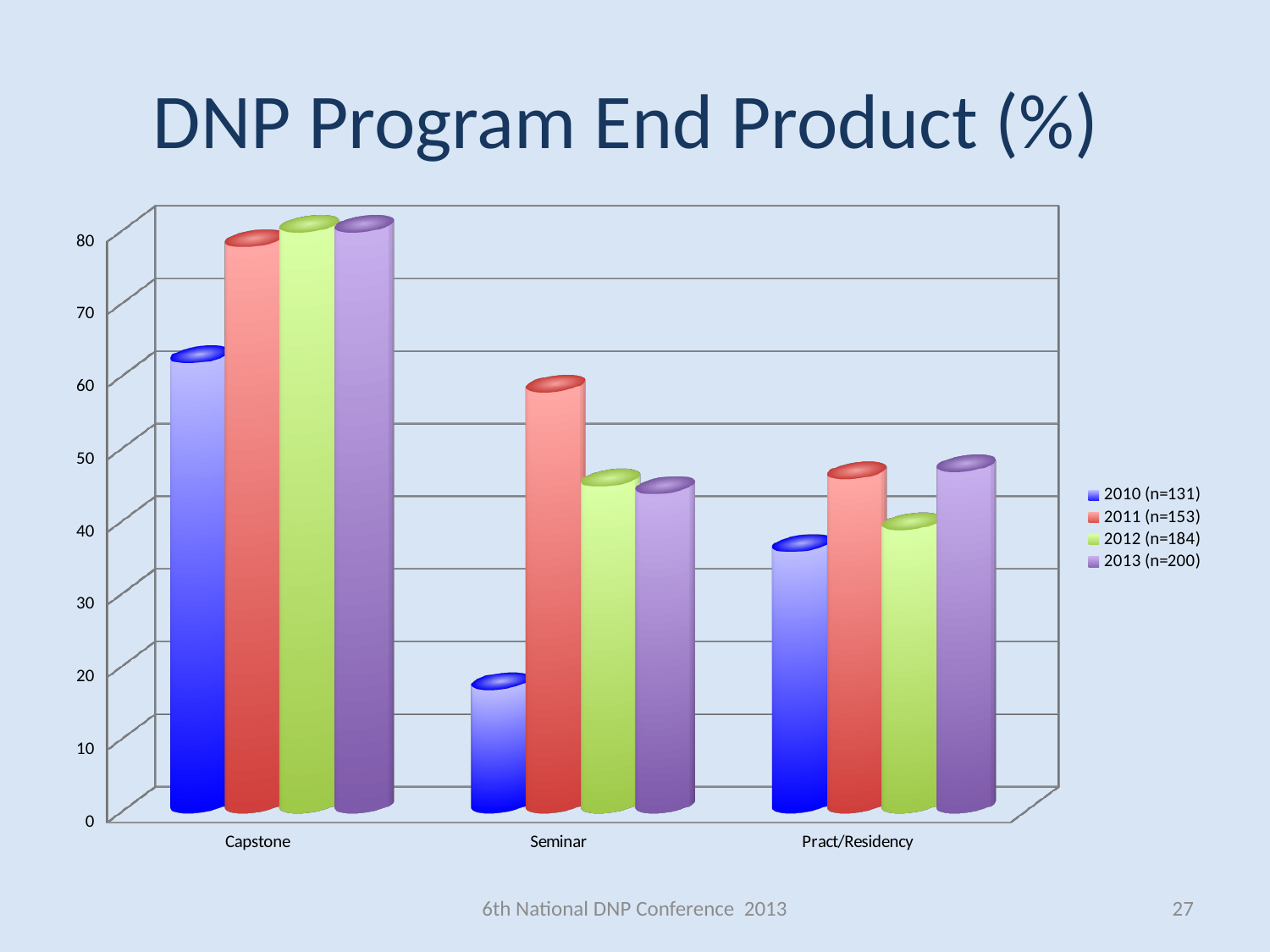
Which category has the lowest value for the 2010 (n=131) series? Seminar Within the Seminar category, which series has the lowest value? 2010 (n=131) What kind of chart is shown on the slide? bar chart How many categories are shown on the x axis? 3 What is the title of the chart? DNP Program End Product (%) For Seminar, which is larger: the 2010 (n=131) value or the 2011 (n=153) value? 2011 (n=153) How many series does the legend list? 4 Is the value for Pract/Residency in the 2011 (n=153) series greater or less than 40? greater For the 2011 (n=153) series, which is larger: Seminar or Pract/Residency? Seminar Is the value for Seminar in the 2010 (n=131) series greater or less than 30? less Which category has the highest value for the 2011 (n=153) series? Capstone Is the value for Capstone in the 2011 (n=153) series greater or less than 70? greater